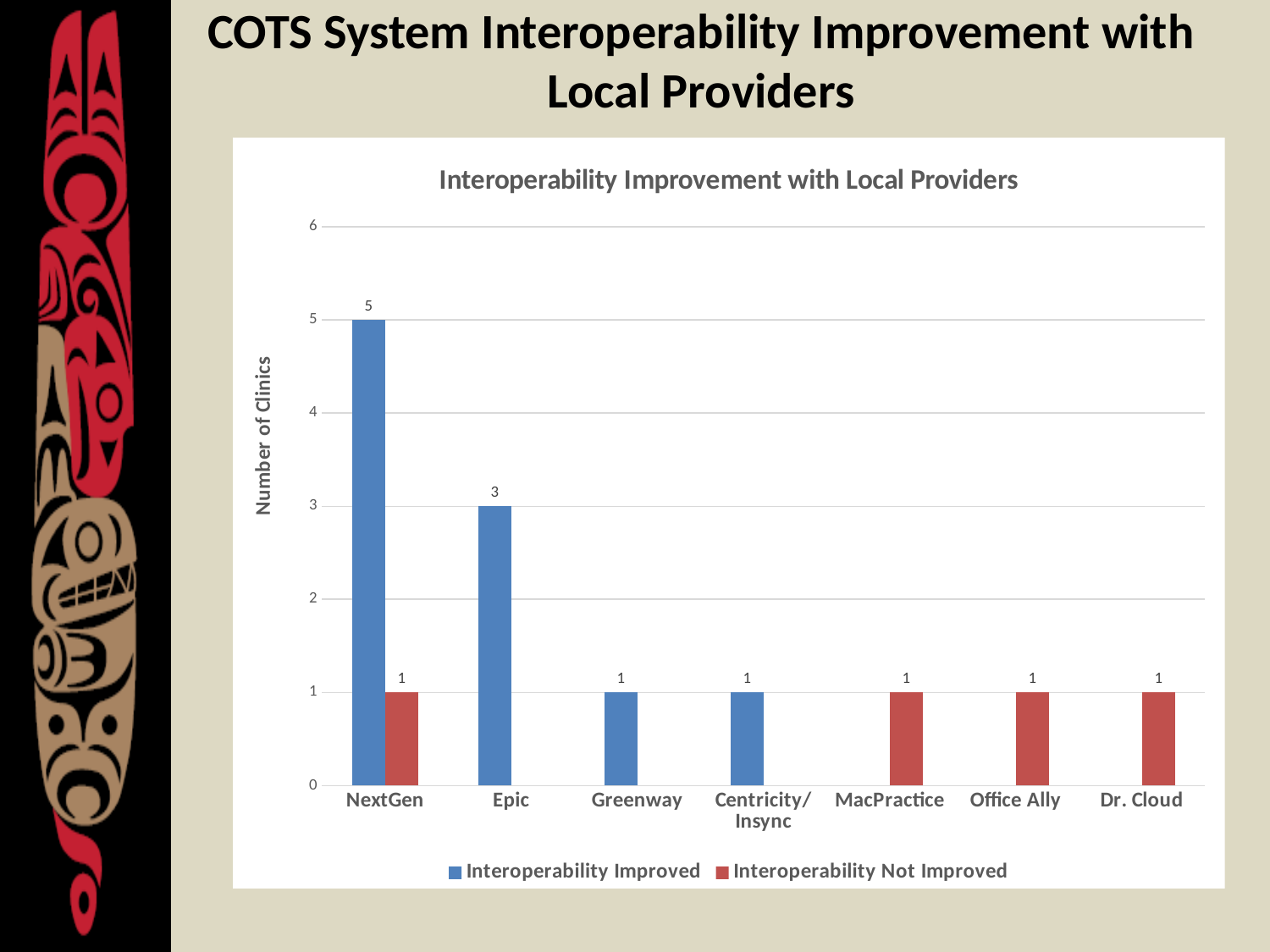
What kind of chart is shown on the slide? Bar chart What is the difference between the Interoperability Improved values for NextGen and Epic? 2 What is the value for Interoperability Not Improved for Office Ally? 1 What is the value for Interoperability Not Improved for NextGen? 1 What is the value for Interoperability Improved for Epic? 3 Which is larger for NextGen: Interoperability Improved or Interoperability Not Improved? Interoperability Improved Which category has the highest value for Interoperability Improved? NextGen What is the label of the vertical axis? Number of Clinics What is the value for Interoperability Improved for NextGen? 5 How many series does the legend list? 2 What is the title of the chart? Interoperability Improvement with Local Providers How many categories are shown on the x axis? 7